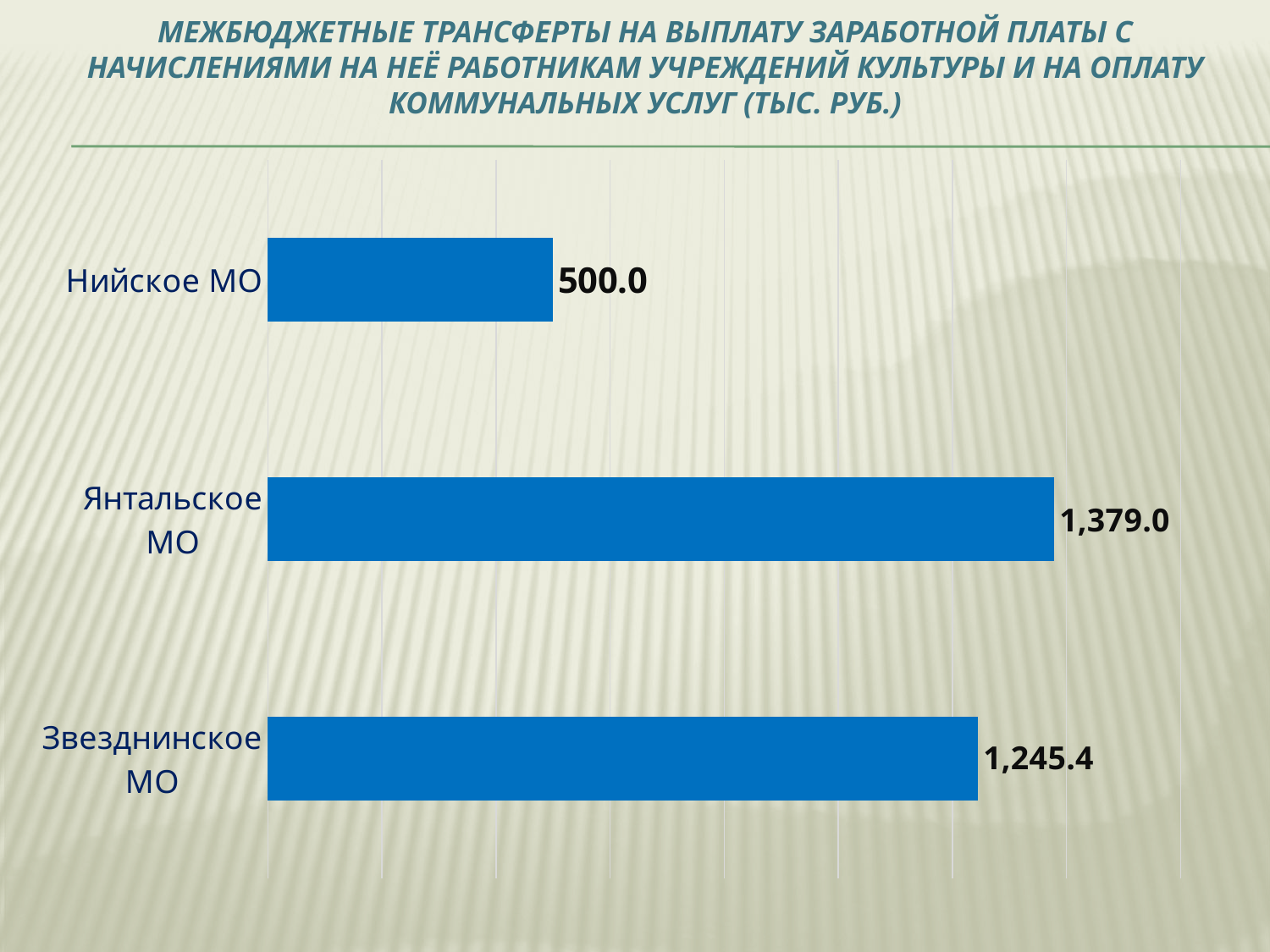
Which is larger, the value for Звезднинское МО or the value for Нийское МО? Звезднинское МО What is the value for Нийское МО? 500.0 In what units are the values in the chart expressed, according to the title? тыс. руб. What is the value for Звезднинское МО? 1,245.4 What is the total of the three values shown in the chart? 3,124.4 What is the difference between the values for Янтальское МО and Нийское МО? 879.0 How many categories are shown in the chart? 3 What kind of chart is shown on the slide? bar chart Which category has the highest value? Янтальское МО Which category has the lowest value? Нийское МО What is the value for Янтальское МО? 1,379.0 What is the difference between the values for Янтальское МО and Звезднинское МО? 133.6